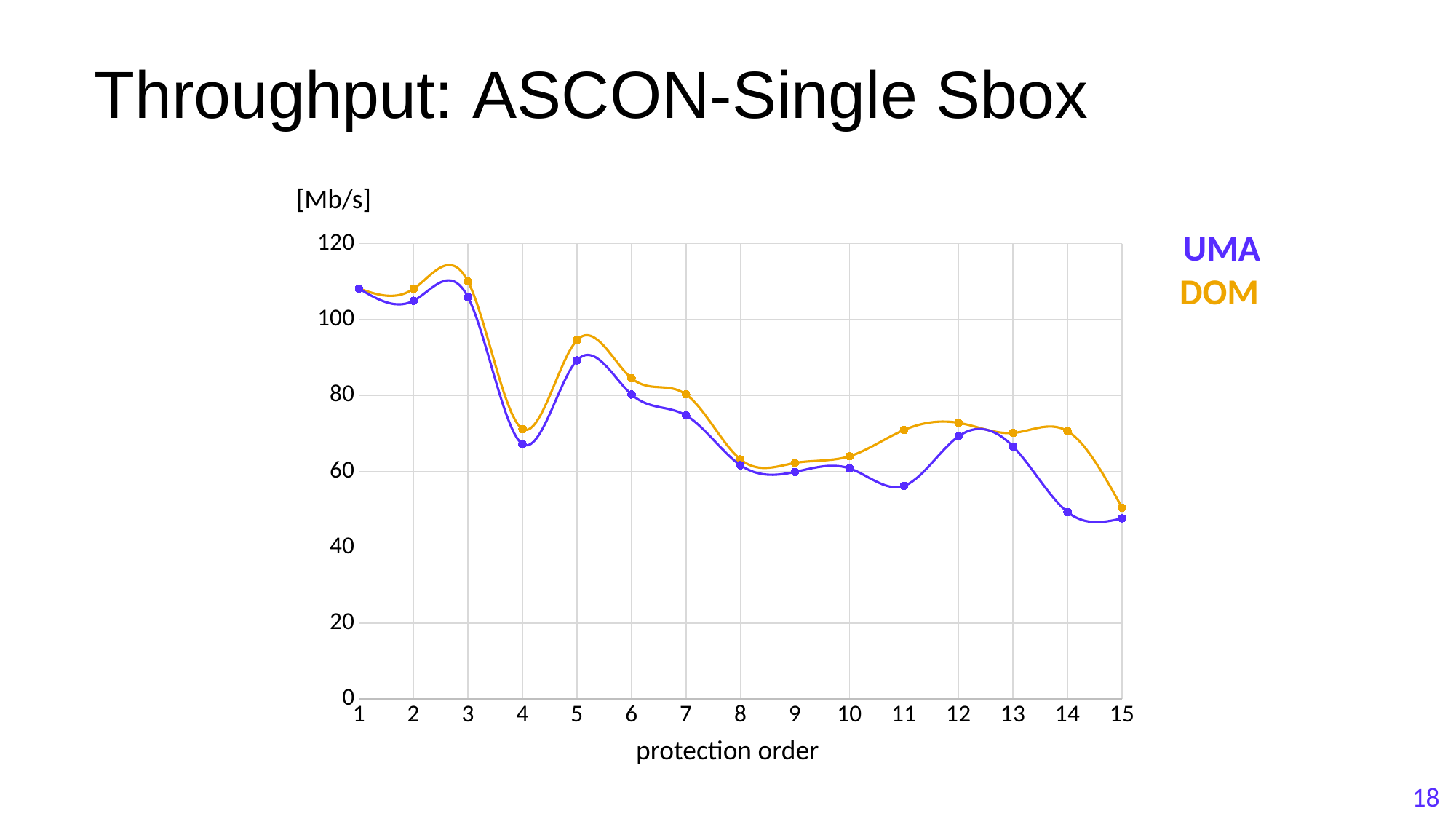
At protection order 11, which series has the higher throughput, UMA or DOM? DOM Is the UMA value at protection order 14 greater or less than 60? less Is the UMA value at protection order 1 greater or less than 100? greater Is the UMA value at protection order 4 greater or less than 80? less At which protection order is the DOM throughput lowest? 15 How many protection orders are plotted along the x axis? 15 At protection order 14, which series has the higher throughput, UMA or DOM? DOM How many series does the legend list? 2 What is the label of the x axis? protection order What kind of chart is shown on the slide? line chart Overall, do the throughput values rise or fall as the protection order increases from 1 to 15? fall